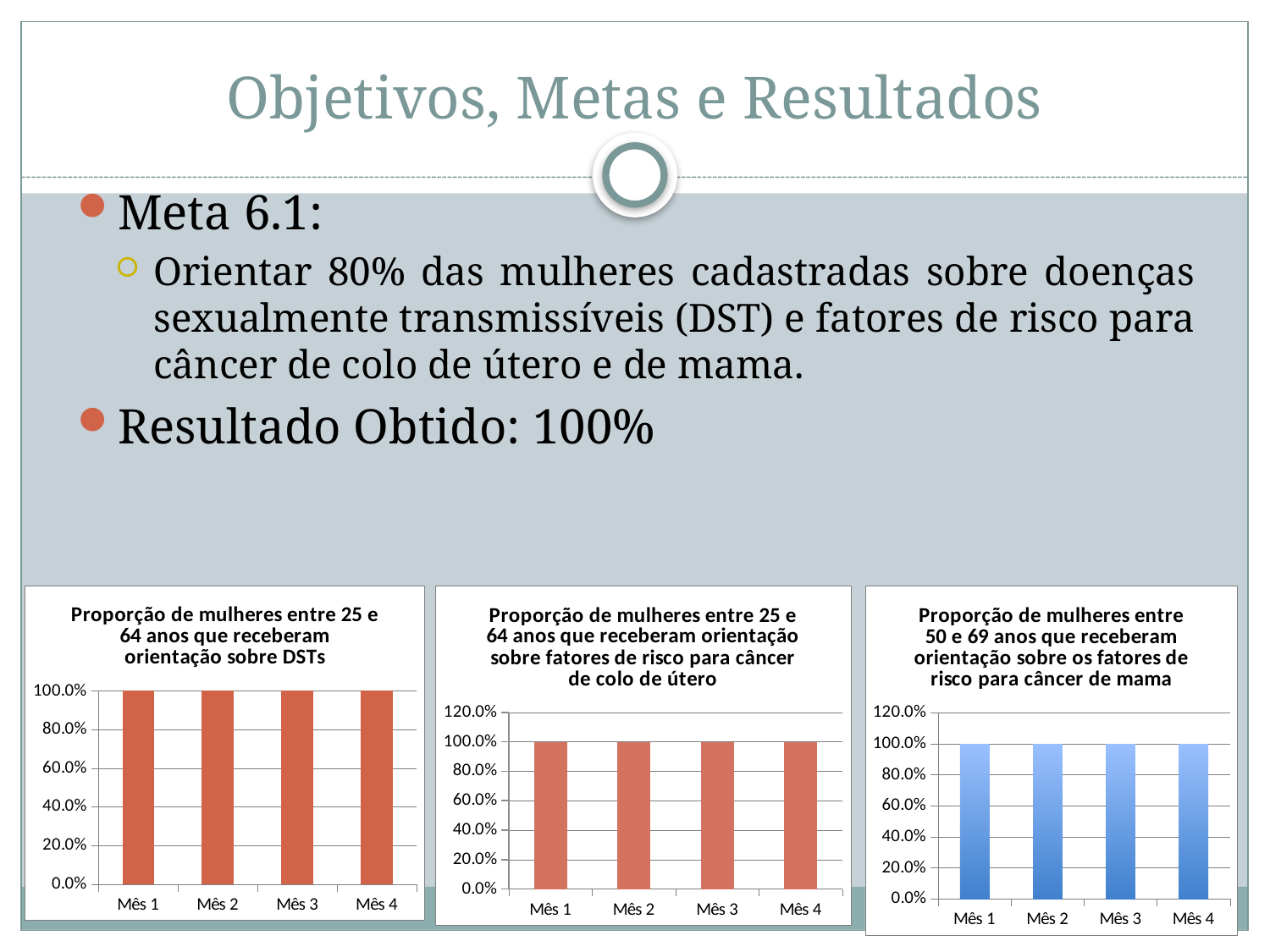
In the left chart (Proporção de mulheres entre 25 e 64 anos que receberam orientação sobre DSTs), what is the value for Mês 1? 100.0% What is the highest value shown on the y axis of the right chart (câncer de mama)? 120.0% What colour are the bars in the right chart (câncer de mama)? blue In the left chart (orientação sobre DSTs), do the values rise, fall or stay the same from Mês 1 to Mês 4? stay the same In the middle chart (orientação sobre fatores de risco para câncer de colo de útero), what is the value for Mês 3? 100.0% In the middle chart (câncer de colo de útero), is the value for Mês 2 greater or less than 80.0%? greater How many bars does the right chart (câncer de mama) have? 4 In the right chart (mulheres entre 50 e 69 anos, câncer de mama), what is the value for Mês 4? 100.0% How many categories are shown on the x axis of the left chart? 4 What kind of chart is the middle chart (câncer de colo de útero)? bar chart How many charts are shown on the slide? 3 In the right chart (câncer de mama), what is the difference between the values for Mês 1 and Mês 4? 0.0%